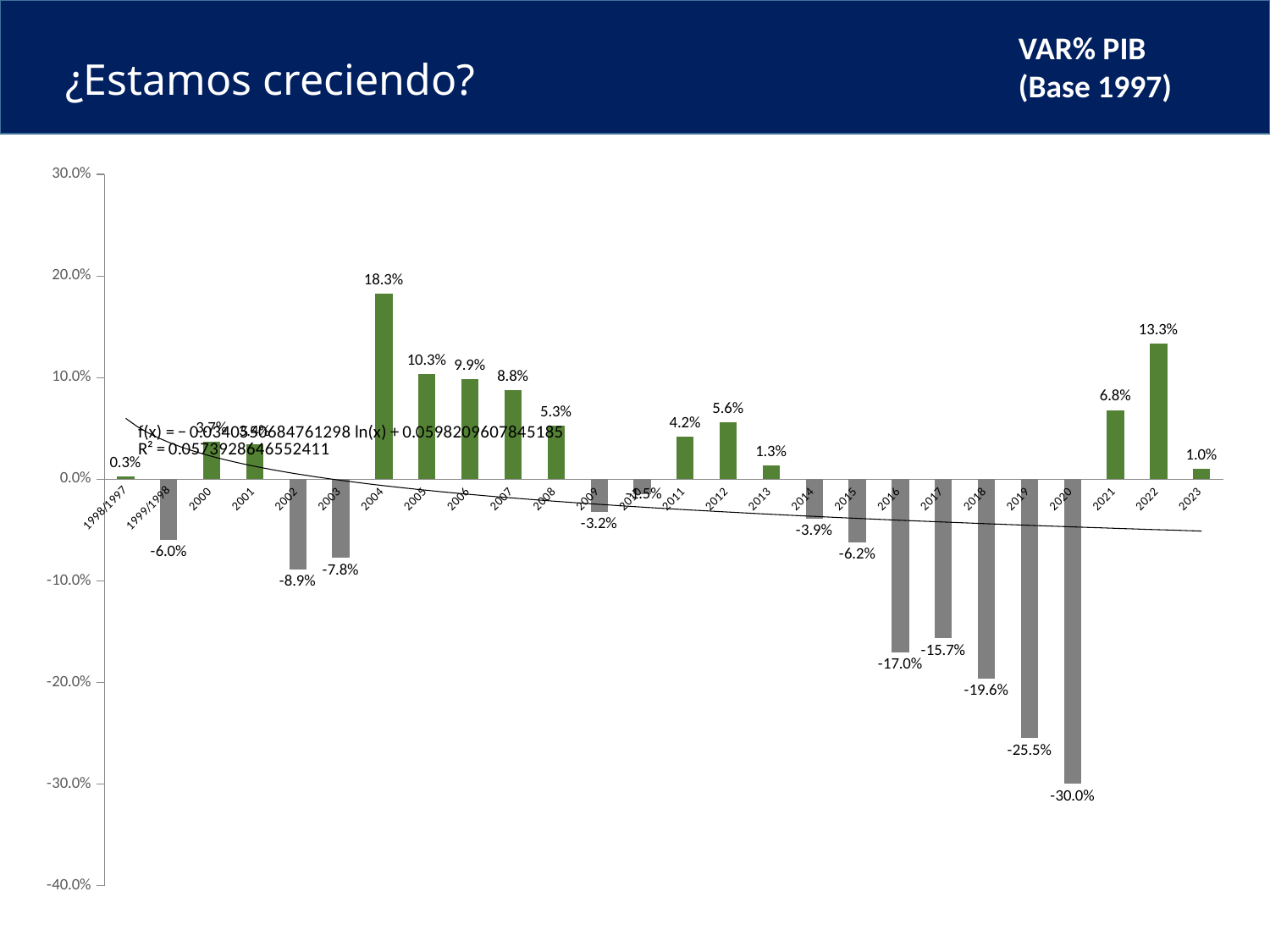
What kind of chart is shown on the slide? bar chart Which is larger, the value for 2021 or the value for 2012? 2021 What is the title shown in the top-right box of the slide? VAR% PIB (Base 1997) How many bars are plotted on the chart? 26 What is the value for 2004? 18.3% Is the value for 2019 greater or less than -20.0%? less What is the value for 2022? 13.3% What is the value for 2016? -17.0% What is the value for 2020? -30.0% Which year has the lowest value? 2020 What is the difference between the values for 2005 and 2006? 0.4% Which year has the highest value? 2004